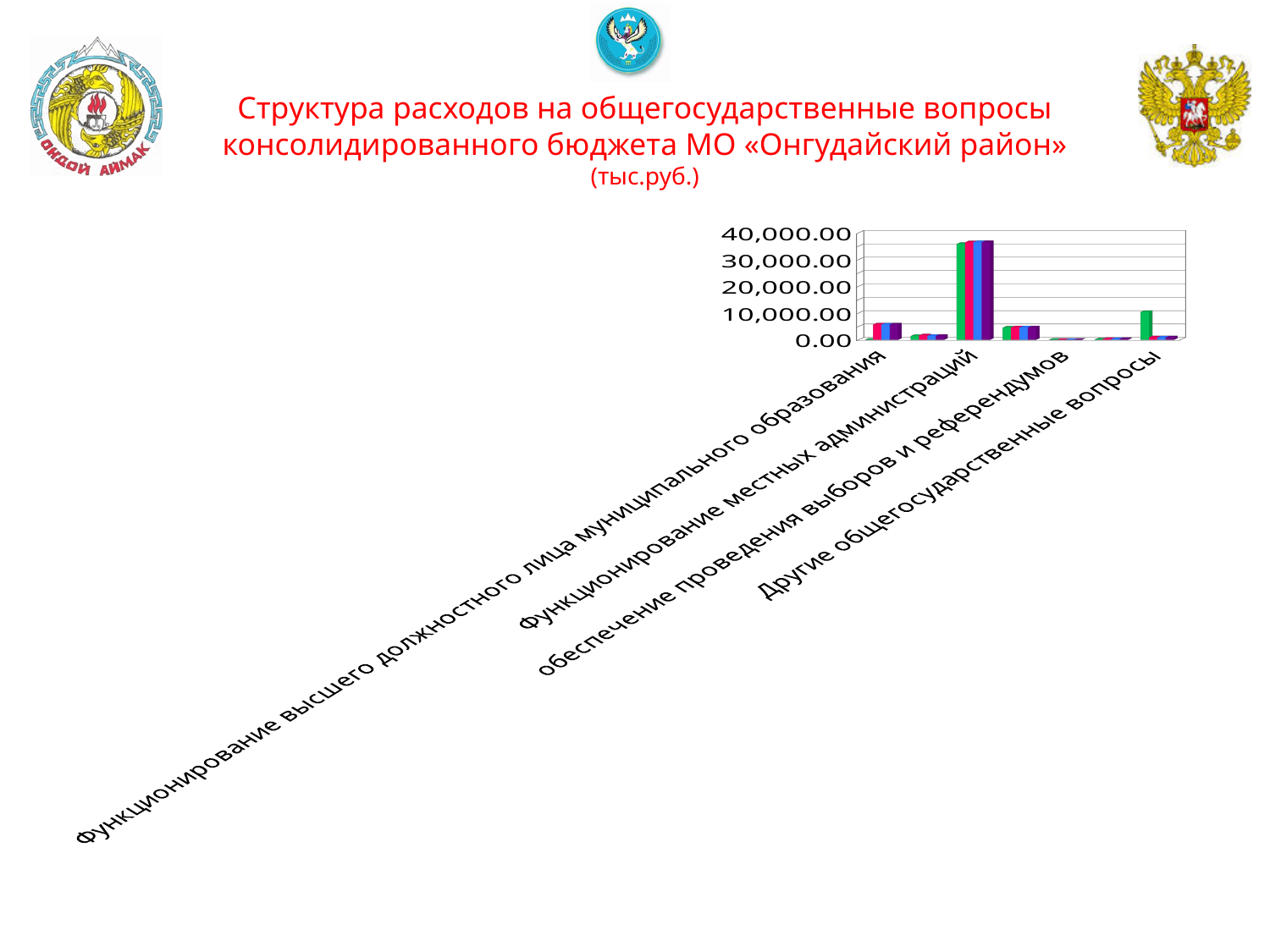
What is the highest value shown on the vertical axis of the chart? 40,000.00 Are the values for Функционирование местных администраций greater or less than 30,000.00? greater Which is larger: the value for Функционирование местных администраций or the value for Функционирование высшего должностного лица муниципального образования? Функционирование местных администраций Are the values for Функционирование высшего должностного лица муниципального образования greater or less than 10,000.00? less In what units are the values in the chart expressed, according to the slide title? тыс.руб. Which labelled category has the lowest bars in the chart? обеспечение проведения выборов и референдумов What kind of chart is shown on the slide? bar chart Which is larger: the value for Функционирование местных администраций or the value for Другие общегосударственные вопросы? Функционирование местных администраций Which category has the highest bars in the chart? Функционирование местных администраций